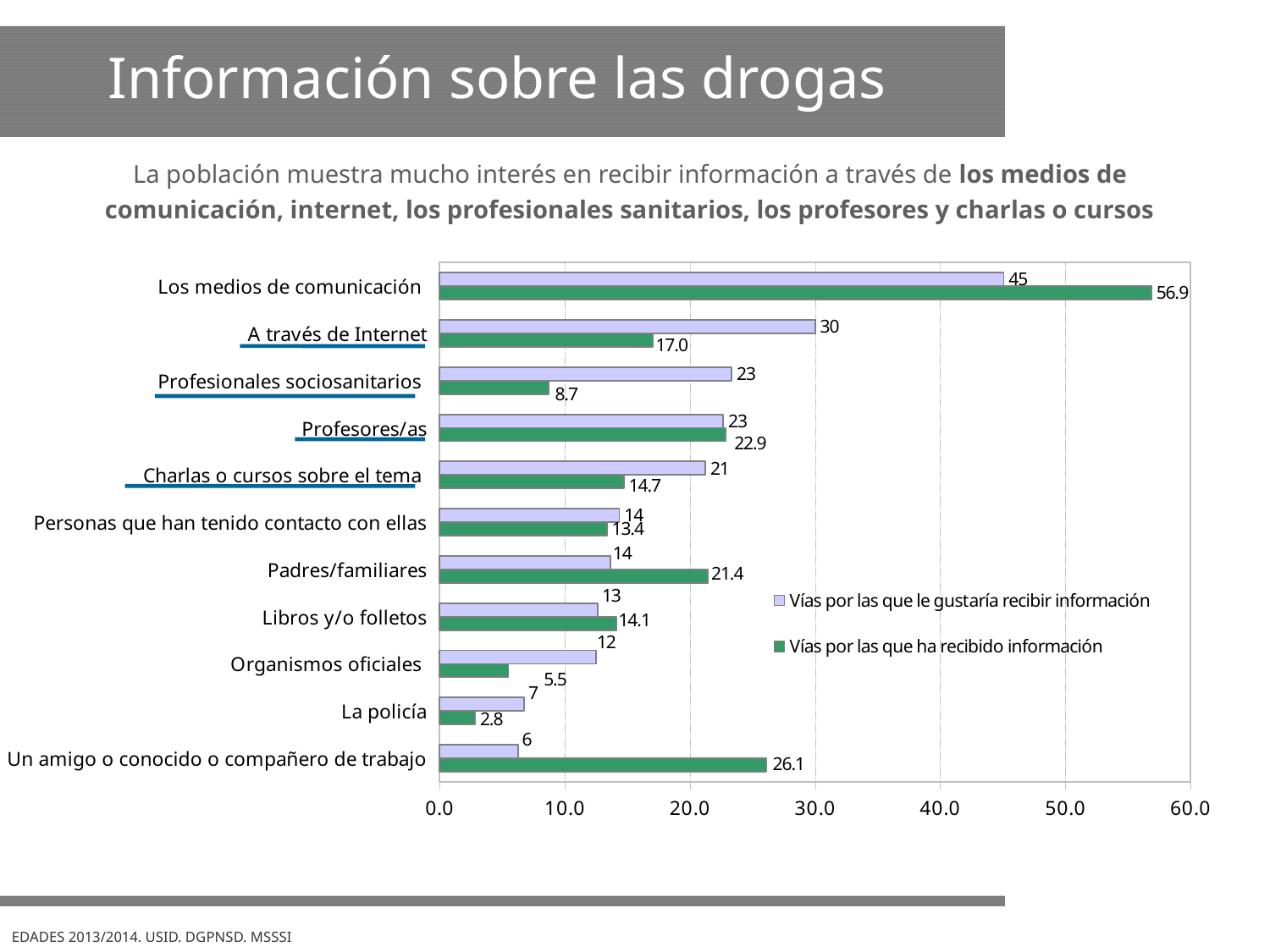
For "Padres/familiares", which series has the larger value? Vías por las que ha recibido información What is the value for "Los medios de comunicación" in the series "Vías por las que ha recibido información"? 56.9 Which colour represents the series "Vías por las que ha recibido información"? Green What is the value for "La policía" in the series "Vías por las que ha recibido información"? 2.8 What is the difference between the two series' values for "Un amigo o conocido o compañero de trabajo"? 20.1 How many categories are shown on the chart? 11 Which category has the lowest value in the series "Vías por las que ha recibido información"? La policía Which category has the highest value in the series "Vías por las que le gustaría recibir información"? Los medios de comunicación How many series does the legend list? 2 What kind of chart is shown on the slide? Bar chart What is the value for "A través de Internet" in the series "Vías por las que le gustaría recibir información"? 30 Is the value for "Los medios de comunicación" in the series "Vías por las que ha recibido información" greater or less than 50.0? greater